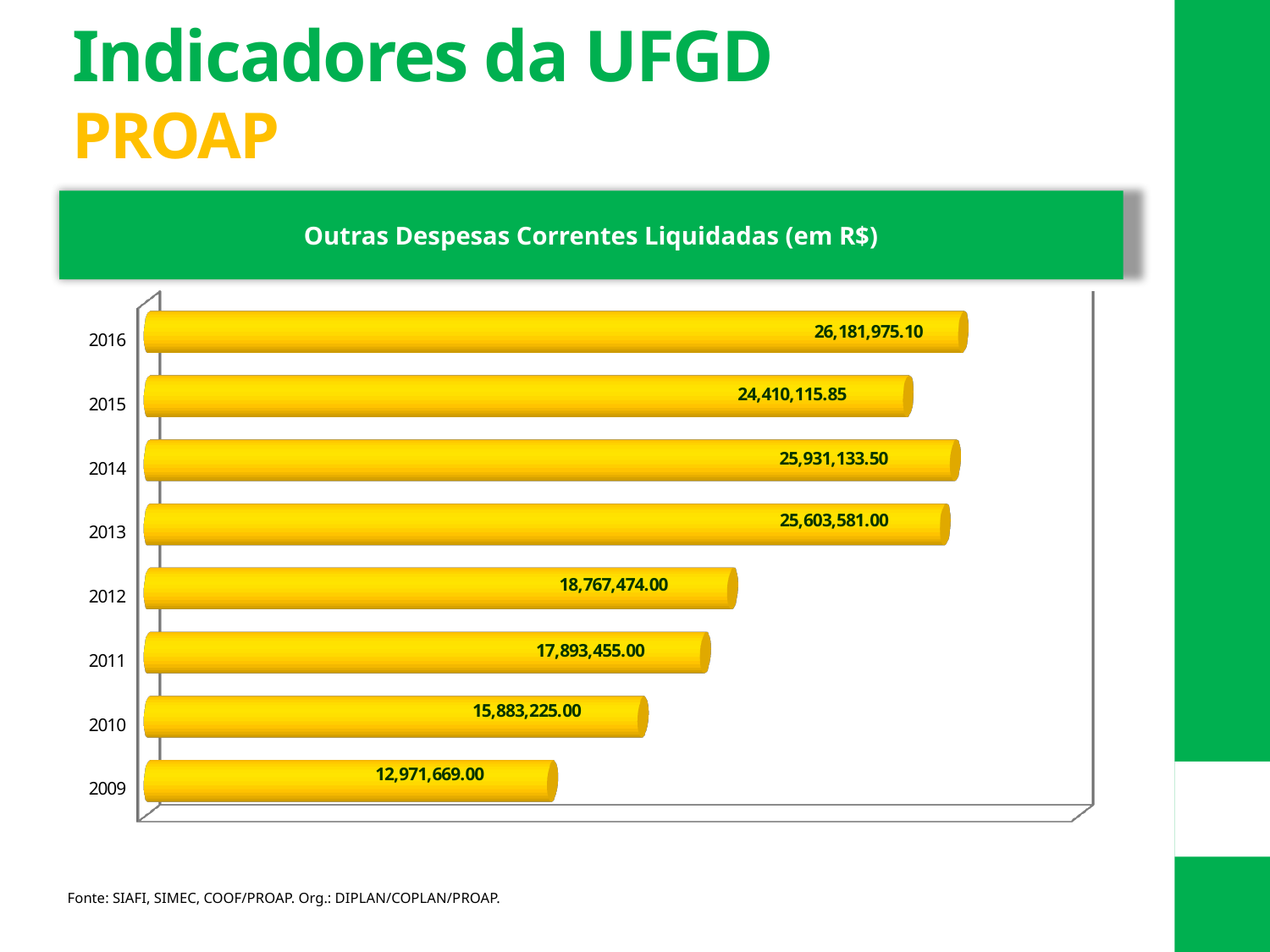
Which is larger, the value for 2014 or the value for 2015? 2014 Which year has the highest value? 2016 What is the value for 2009? 12,971,669.00 What is the difference between the values for 2016 and 2009? 13,210,306.10 What is the value for 2013? 25,603,581.00 Which is larger, the value for 2010 or the value for 2011? 2011 How many years are shown in the chart? 8 Which year has the lowest value? 2009 What is the title of the chart? Outras Despesas Correntes Liquidadas (em R$) What is the difference between the values for 2012 and 2011? 874,019.00 What is the value for 2016? 26,181,975.10 What kind of chart is shown on the slide? Bar chart